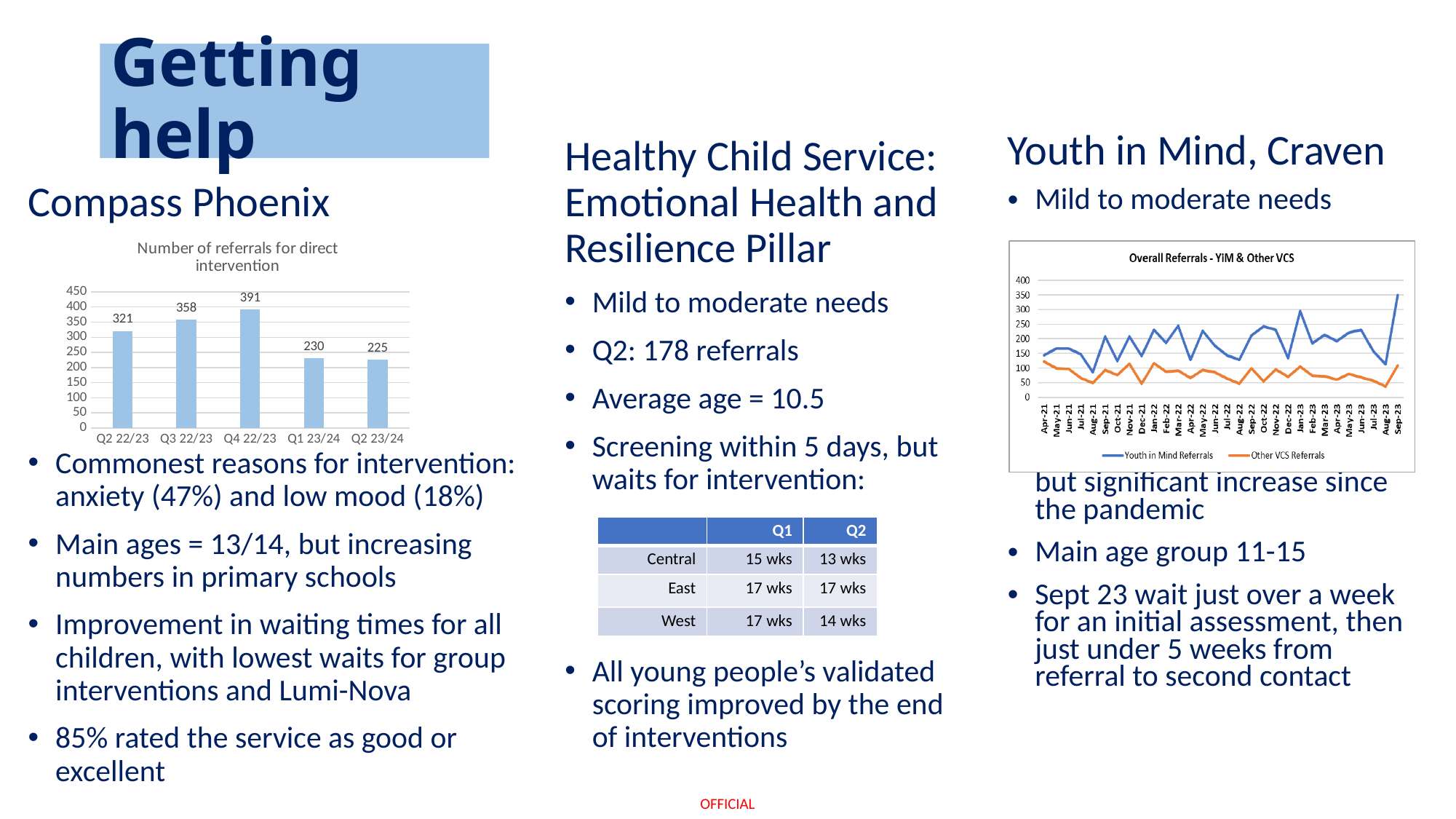
How many series does the legend of the 'Overall Referrals - YiM & Other VCS' chart list? 2 In the 'Number of referrals for direct intervention' chart, what is the value for Q4 22/23? 391 In the 'Number of referrals for direct intervention' chart, which quarter has the highest number of referrals? Q4 22/23 What kind of chart is the 'Number of referrals for direct intervention' chart? Bar chart What kind of chart is the 'Overall Referrals - YiM & Other VCS' chart? Line chart In the 'Number of referrals for direct intervention' chart, what is the value for Q2 23/24? 225 How many bars are shown in the 'Number of referrals for direct intervention' chart? 5 In the 'Overall Referrals - YiM & Other VCS' chart, is the value for Youth in Mind Referrals in Sep-23 greater or less than 300? greater In the 'Number of referrals for direct intervention' chart, what is the difference between the values for Q4 22/23 and Q1 23/24? 161 In the 'Overall Referrals - YiM & Other VCS' chart, which series is shown in orange? Other VCS Referrals In the 'Number of referrals for direct intervention' chart, which is larger: the value for Q2 22/23 or Q3 22/23? Q3 22/23 In the 'Number of referrals for direct intervention' chart, which quarter has the lowest number of referrals? Q2 23/24